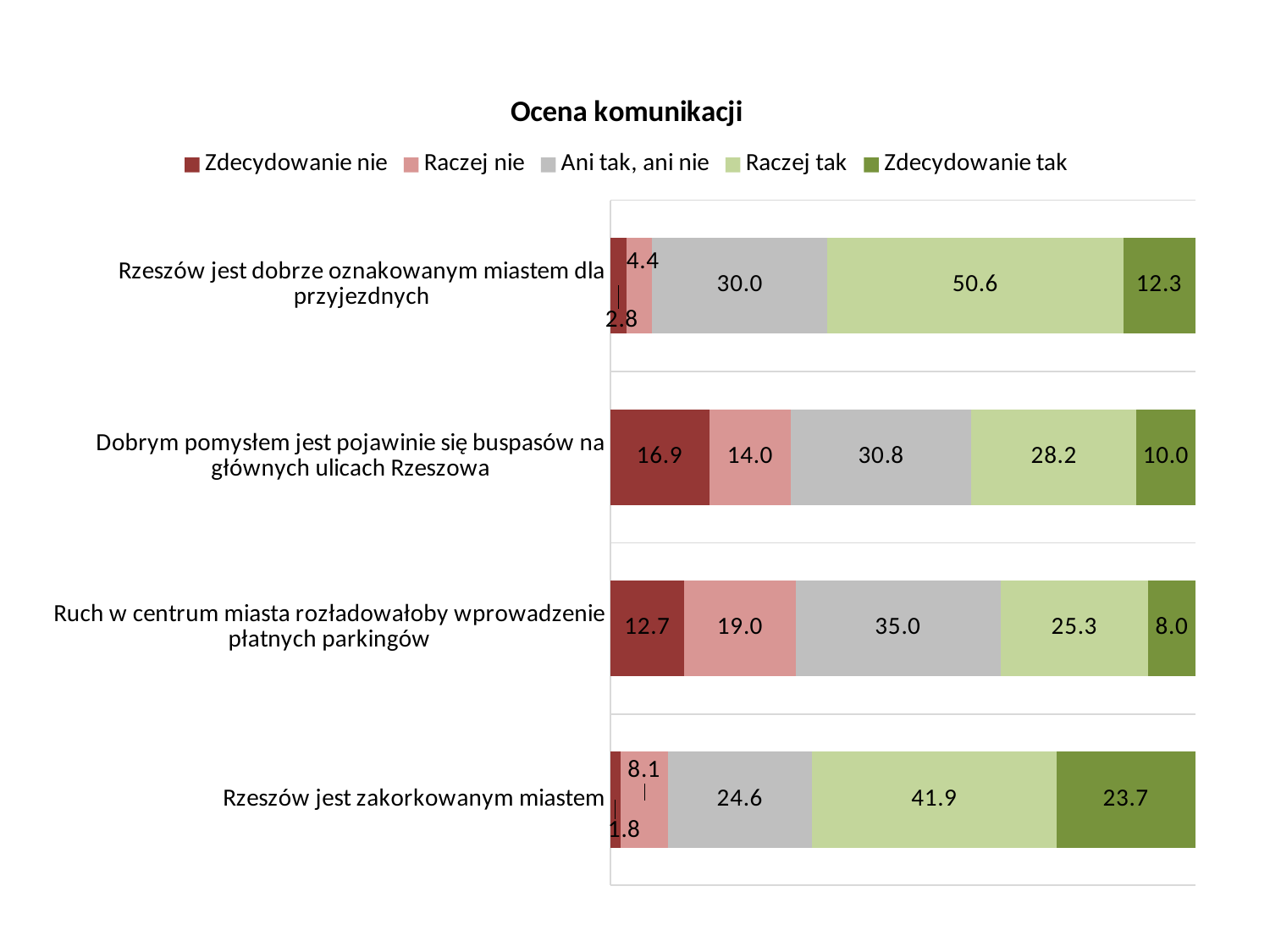
What is the value for "Zdecydowanie nie" in the category "Dobrym pomysłem jest pojawinie się buspasów na głównych ulicach Rzeszowa"? 16.9 How many series does the legend list? 5 In the category "Ruch w centrum miasta rozładowałoby wprowadzenie płatnych parkingów", what is the difference between the "Raczej tak" value and the "Raczej nie" value? 6.3 What is the difference between the "Zdecydowanie tak" value for "Rzeszów jest zakorkowanym miastem" and the "Zdecydowanie tak" value for "Ruch w centrum miasta rozładowałoby wprowadzenie płatnych parkingów"? 15.7 Which category has the larger "Ani tak, ani nie" value: "Dobrym pomysłem jest pojawinie się buspasów na głównych ulicach Rzeszowa" or "Rzeszów jest dobrze oznakowanym miastem dla przyjezdnych"? Dobrym pomysłem jest pojawinie się buspasów na głównych ulicach Rzeszowa How many categories (statements) are shown in the chart? 4 What is the value for "Zdecydowanie tak" in the category "Rzeszów jest zakorkowanym miastem"? 23.7 What is the title of the chart? Ocena komunikacji Which category has the highest value for "Zdecydowanie tak"? Rzeszów jest zakorkowanym miastem Which category has the lowest value for "Zdecydowanie nie"? Rzeszów jest zakorkowanym miastem What kind of chart is shown on the slide? Stacked bar chart What is the value for "Raczej tak" in the category "Rzeszów jest dobrze oznakowanym miastem dla przyjezdnych"? 50.6